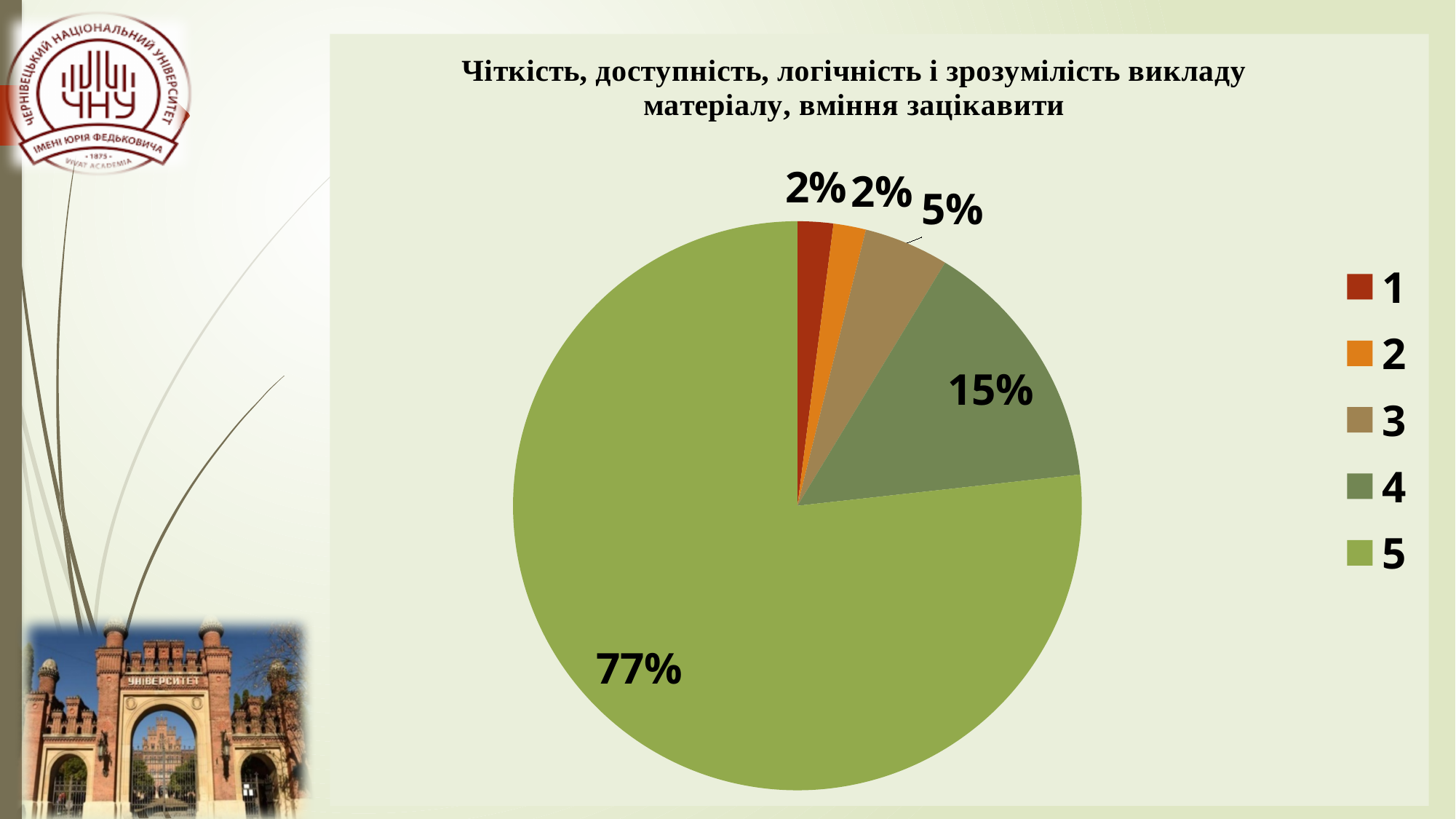
What kind of chart is shown on the slide? pie chart What share of the pie does category 3 have? 5% Which category has the larger slice, 4 or 3? 4 What share of the pie does category 5 have? 77% What share of the pie does category 4 have? 15% What is the difference between the shares of category 5 and category 4? 62% How many entries does the legend list? 5 What share of the pie does category 1 have? 2% How many slices does the pie chart have? 5 Which category has the largest slice of the pie? 5 What colour is the slice for category 1 in the legend? dark red What is the difference between the shares of category 4 and category 3? 10%